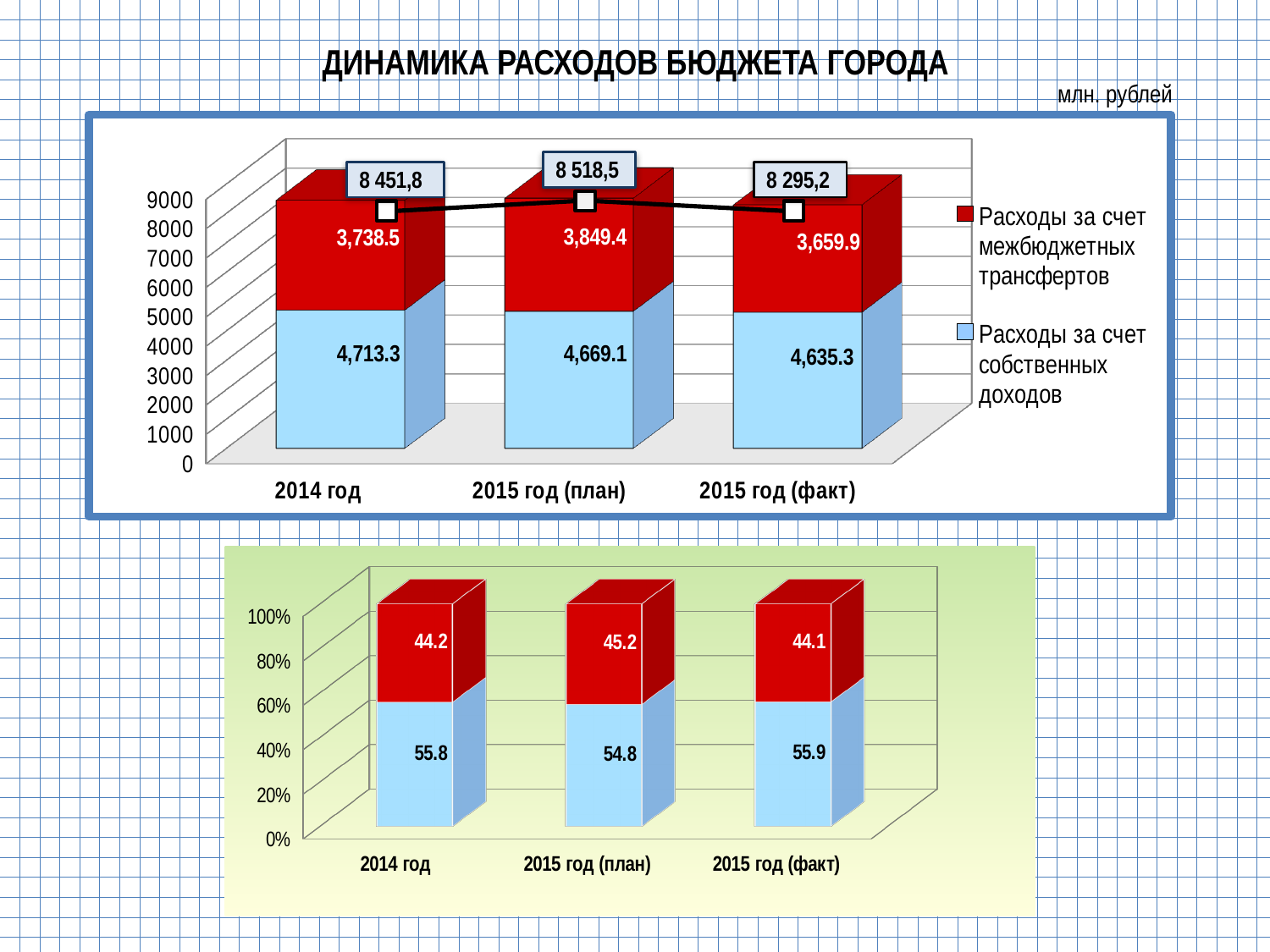
In the top chart, which category has the highest value for Расходы за счет межбюджетных трансфертов? 2015 год (план) What kind of chart is the top chart? stacked bar chart How many series does the legend of the top chart list? 2 In the bottom chart, what is the percentage share for Расходы за счет собственных доходов in 2015 год (план)? 54.8 In the top chart, what is the total shown above the bar for 2015 год (факт)? 8 295,2 In the top chart, is the value for Расходы за счет межбюджетных трансфертов in 2014 год larger or smaller than the value for Расходы за счет собственных доходов in 2014 год? smaller In the bottom chart, which category has the highest share for Расходы за счет межбюджетных трансфертов? 2015 год (план) In the top chart, what is the difference between Расходы за счет собственных доходов and Расходы за счет межбюджетных трансфертов in 2015 год (факт)? 975.4 In the top chart, what is the value for Расходы за счет межбюджетных трансфертов in 2015 год (план)? 3,849.4 In the top chart, what is the value for Расходы за счет собственных доходов in 2014 год? 4,713.3 How many categories are shown on the x axis of the bottom chart? 3 In the top chart, which category has the lowest value for Расходы за счет собственных доходов? 2015 год (факт)